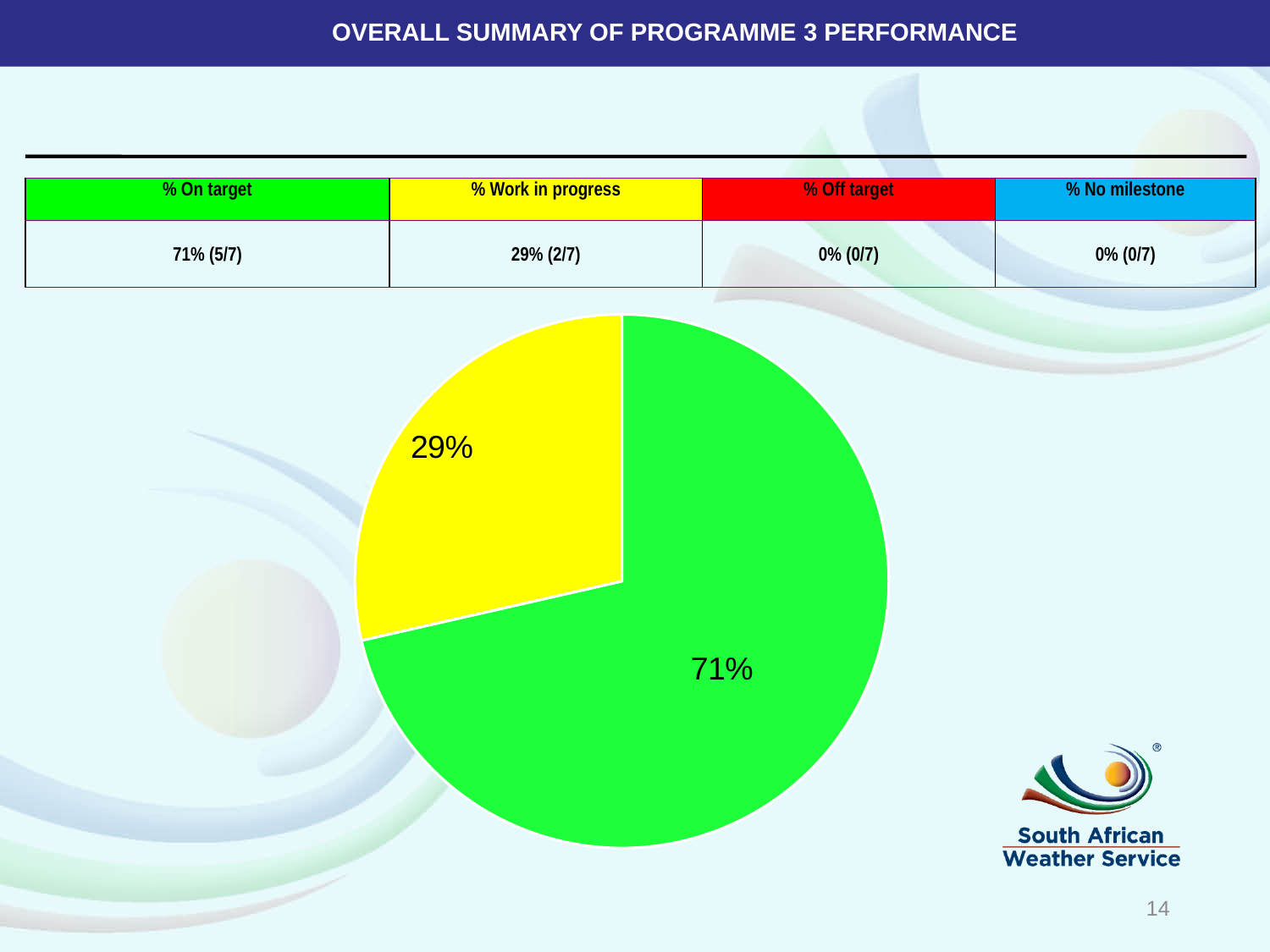
How many slices with a visible share are shown in the pie chart? 2 Which slice of the pie chart is the smallest? the yellow slice (29%) Which slice of the pie chart is the largest? the green slice (71%) What percentage is shown on the green slice of the pie chart? 71% Which is larger in the pie chart, the green slice or the yellow slice? the green slice Is the share of the yellow slice in the pie chart greater or less than 50%? less According to the table above the pie chart, what category does the yellow colour represent? % Work in progress What kind of chart is shown on the slide? pie chart What is the difference in percentage points between the green slice and the yellow slice of the pie chart? 42 What share of the pie chart does the green slice take up? 71% What percentage is shown on the yellow slice of the pie chart? 29% According to the table above the pie chart, what category does the green colour represent? % On target